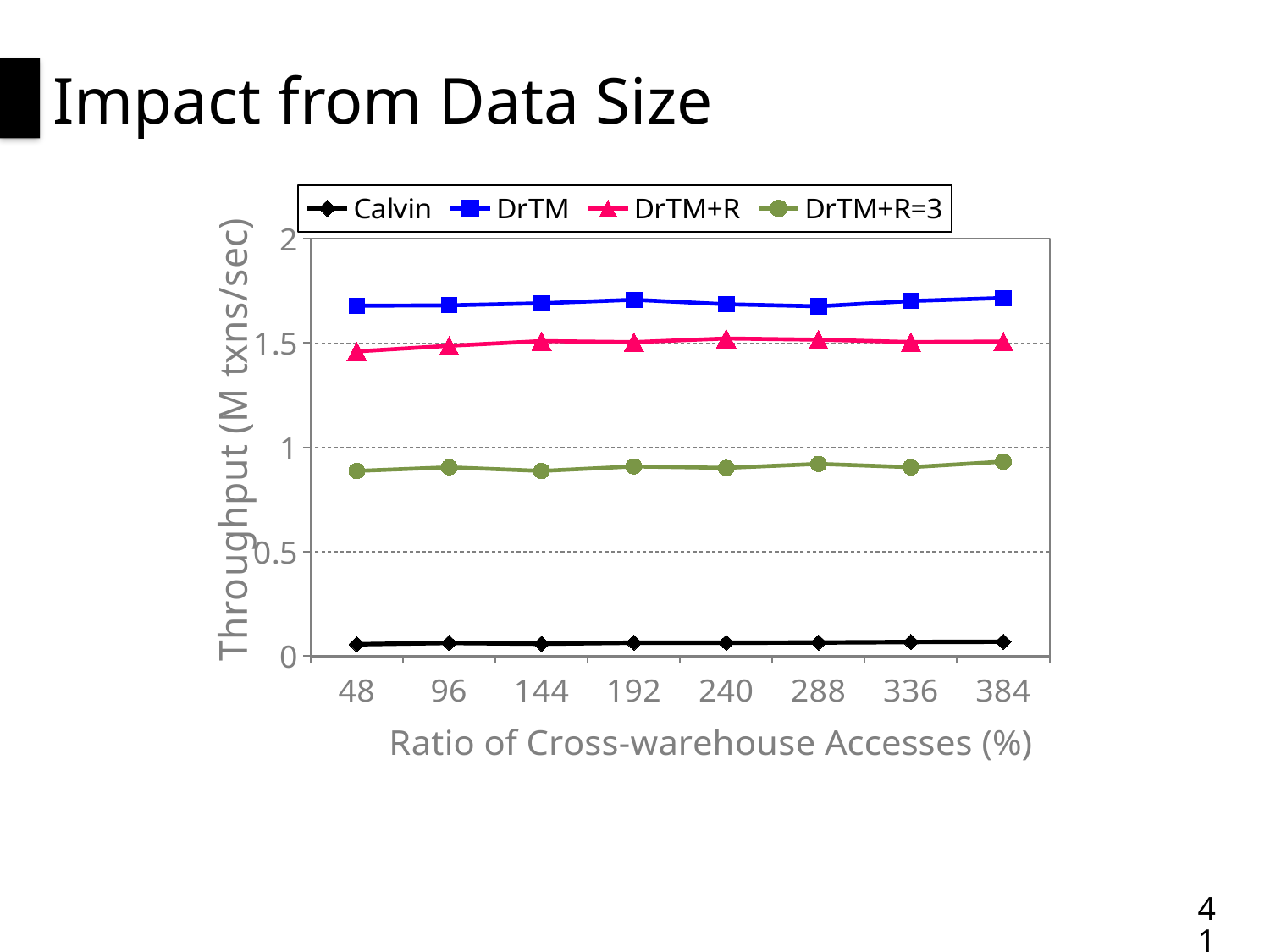
Is the throughput for DrTM+R=3 at 384 greater or less than 1? less What is the label of the x axis? Ratio of Cross-warehouse Accesses (%) Which series has the lowest throughput across the chart? Calvin How many series does the legend list? 4 At 240, which series has the higher throughput, DrTM+R or DrTM+R=3? DrTM+R Which series has the highest throughput across the chart? DrTM How many x-axis points are plotted for each series? 8 Is the throughput for DrTM+R at 48 greater or less than 1? greater What kind of chart is shown on the slide? line chart What is the label of the y axis? Throughput (M txns/sec) Is the throughput for DrTM at 48 greater or less than 1.5? greater